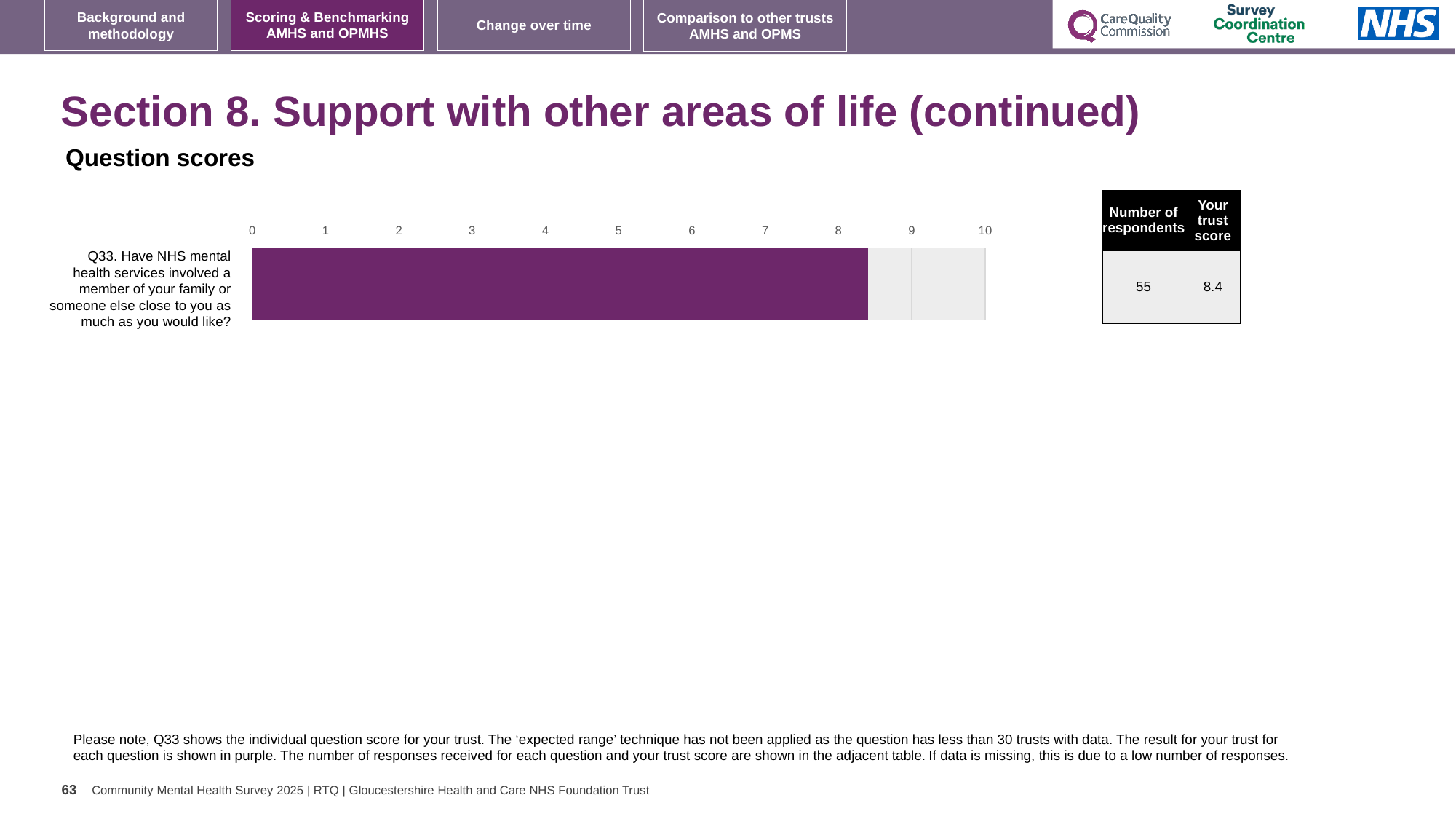
How many respondents are listed for Q33 in the adjacent table? 55 How many questions (bars) are plotted in the chart? 1 What colour is the bar for Q33? purple Is the value of the bar for Q33 greater or less than 8? greater Is the value of the bar for Q33 greater or less than 5? greater What kind of chart is shown on the slide? bar chart Is the value of the bar for Q33 greater or less than 9? less What is the highest value shown on the chart's axis? 10 What is the trust score for Q33 shown in the adjacent table? 8.4